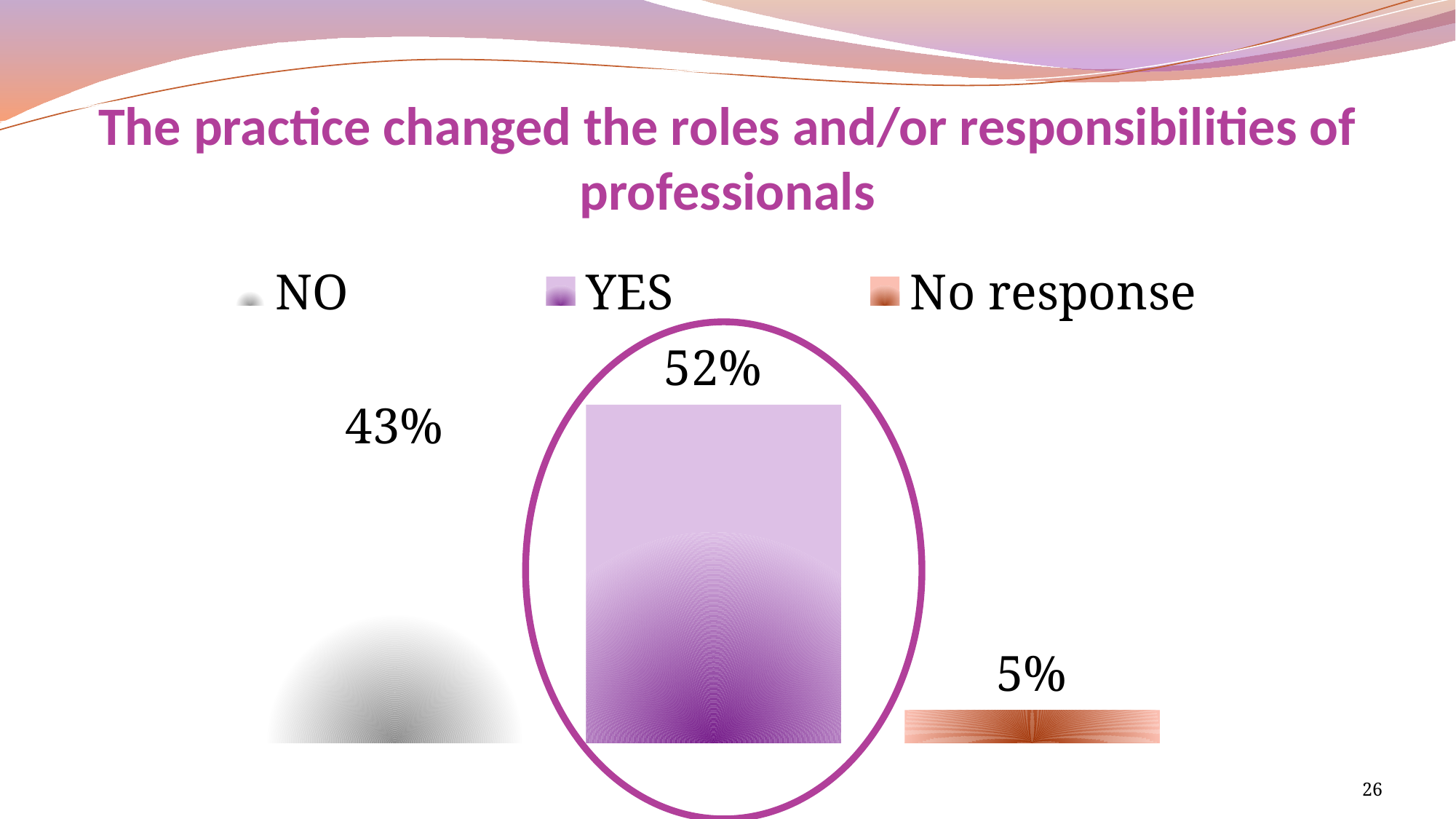
What percentage of respondents answered NO? 43% Which response category has the lowest value? No response Which response category has the highest value? YES Which category's bar is circled on the slide? YES Which is larger, the value for YES or the value for NO? YES How many response categories are shown in the chart? 3 What is the difference between the NO and No response percentages? 38% How many entries does the legend list? 3 What kind of chart is shown on the slide? Bar chart What percentage of respondents answered YES? 52% What is the difference between the YES and NO percentages? 9% What percentage is shown for No response? 5%